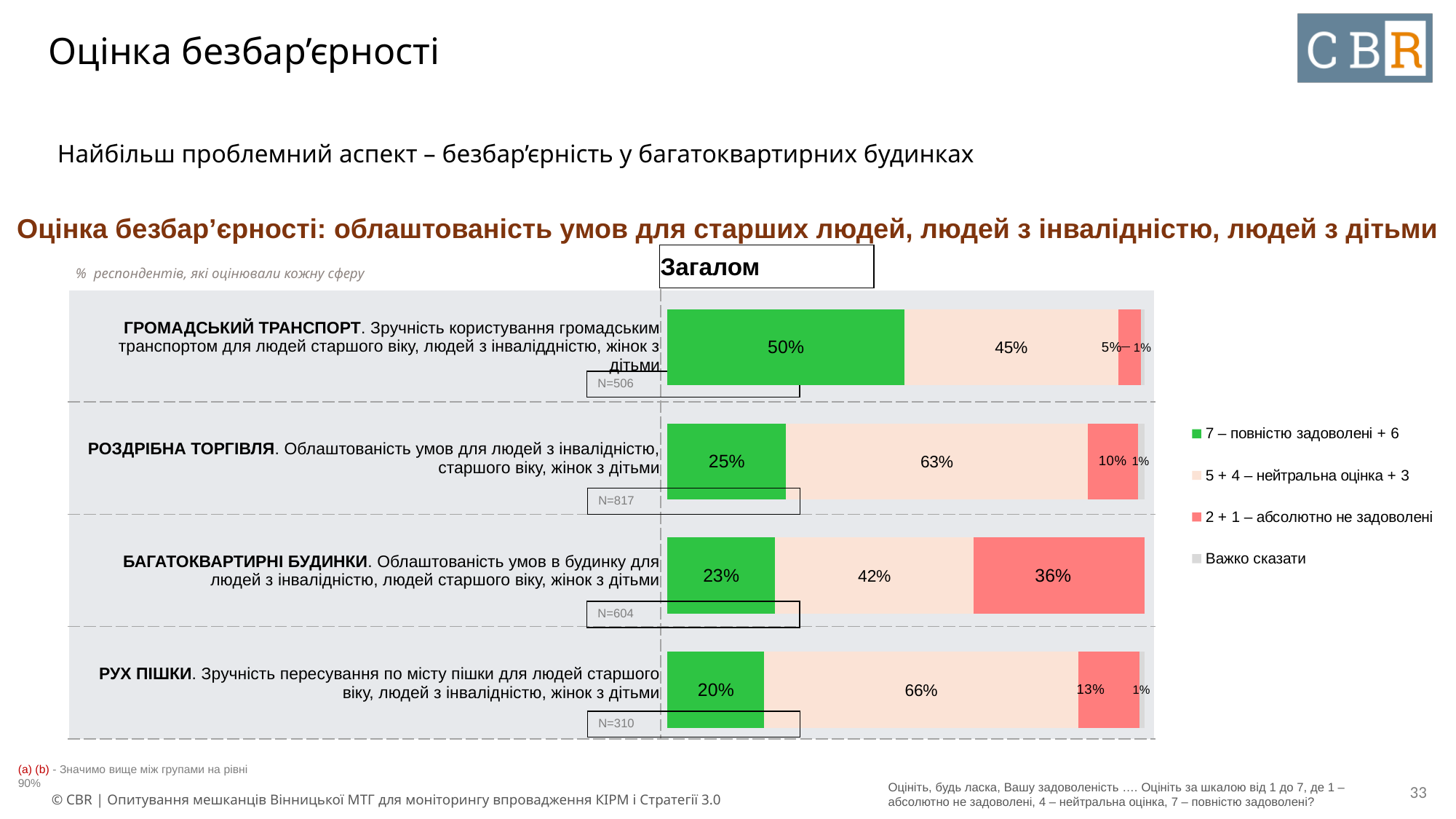
What is the difference between the absolutely dissatisfied share for БАГАТОКВАРТИРНІ БУДИНКИ and for РОЗДРІБНА ТОРГІВЛЯ? 26% What colour represents the series '2 + 1 – абсолютно не задоволені' in the legend? red What share of respondents gave a rating of 7 or 6 (повністю задоволені) for ГРОМАДСЬКИЙ ТРАНСПОРТ? 50% How many series does the legend list? 4 How many categories (spheres) are plotted in the chart? 4 Which category has the lowest share of fully satisfied respondents (7 + 6)? РУХ ПІШКИ What share of respondents gave a neutral rating (5 + 4 + 3) for РУХ ПІШКИ? 66% What share of respondents were absolutely dissatisfied (2 + 1) with БАГАТОКВАРТИРНІ БУДИНКИ? 36% What is the sample size (N) shown for РОЗДРІБНА ТОРГІВЛЯ? N=817 Which is larger: the neutral share for РОЗДРІБНА ТОРГІВЛЯ or the neutral share for ГРОМАДСЬКИЙ ТРАНСПОРТ? РОЗДРІБНА ТОРГІВЛЯ Which category has the highest share of fully satisfied respondents (7 + 6)? ГРОМАДСЬКИЙ ТРАНСПОРТ What kind of chart is shown on the slide? stacked bar chart